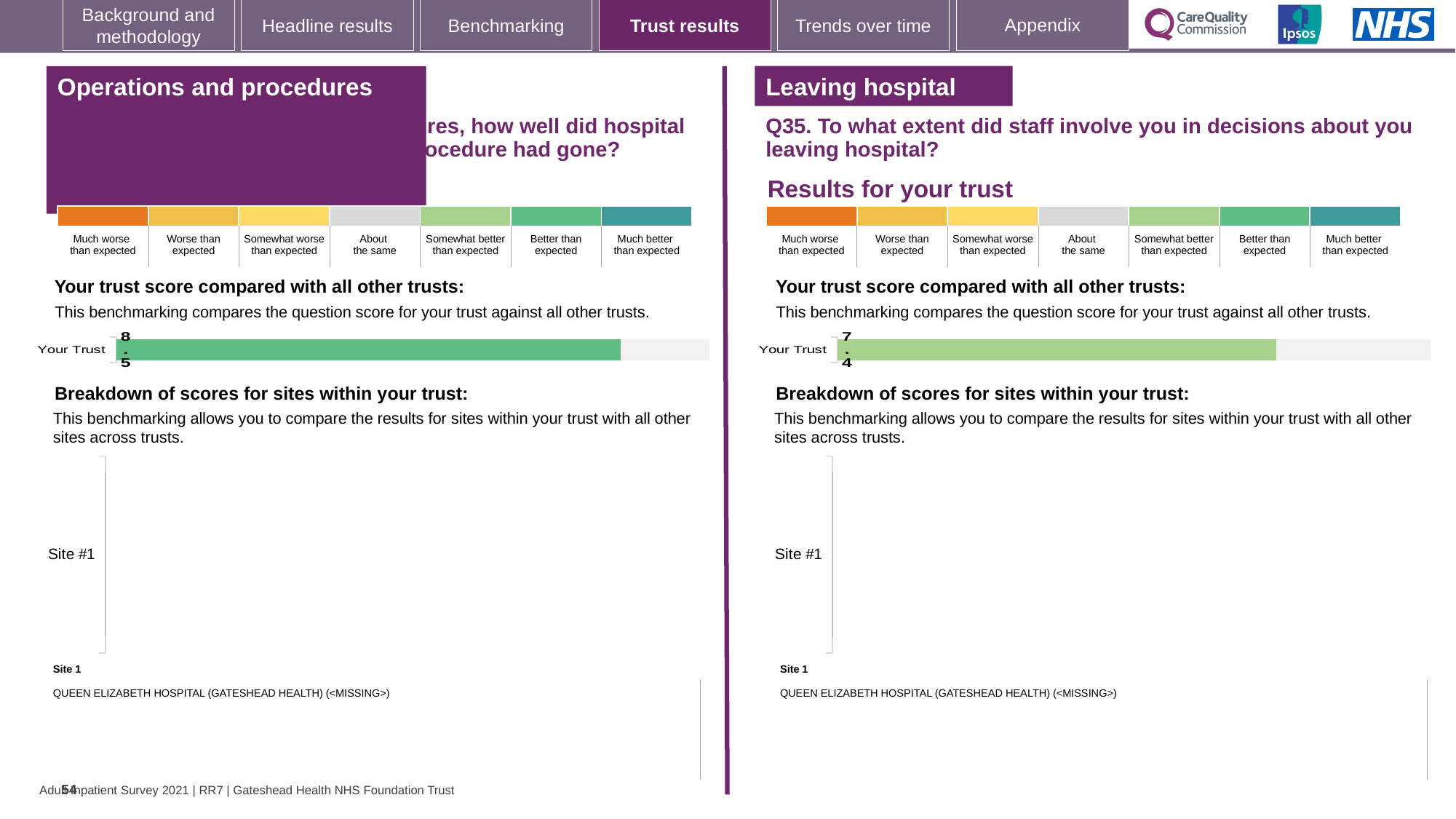
Which chart shows the higher Your Trust score: 'Operations and procedures' or 'Leaving hospital'? Operations and procedures How many rating categories does the colour key above the 'Leaving hospital' chart list? 7 What is the difference between the Your Trust score on the 'Operations and procedures' chart and the Your Trust score on the 'Leaving hospital' chart? 1.1 On the 'Leaving hospital' site breakdown chart, how many sites are listed? 1 On the 'Operations and procedures' trust score chart, how many bars are plotted? 1 Is the Your Trust score on the 'Leaving hospital' chart greater or less than the Your Trust score on the 'Operations and procedures' chart? less On the 'Leaving hospital' (Q35) chart, what is the score shown for Your Trust? 7.4 On the 'Leaving hospital' chart, which rating category does the colour of the Your Trust bar correspond to? Somewhat better than expected On the 'Operations and procedures' chart, what is the score shown for Your Trust? 8.5 What kind of chart is used to show the Your Trust score on the 'Leaving hospital' side of the slide? Bar chart On the 'Operations and procedures' chart, which rating category does the colour of the Your Trust bar correspond to? Better than expected